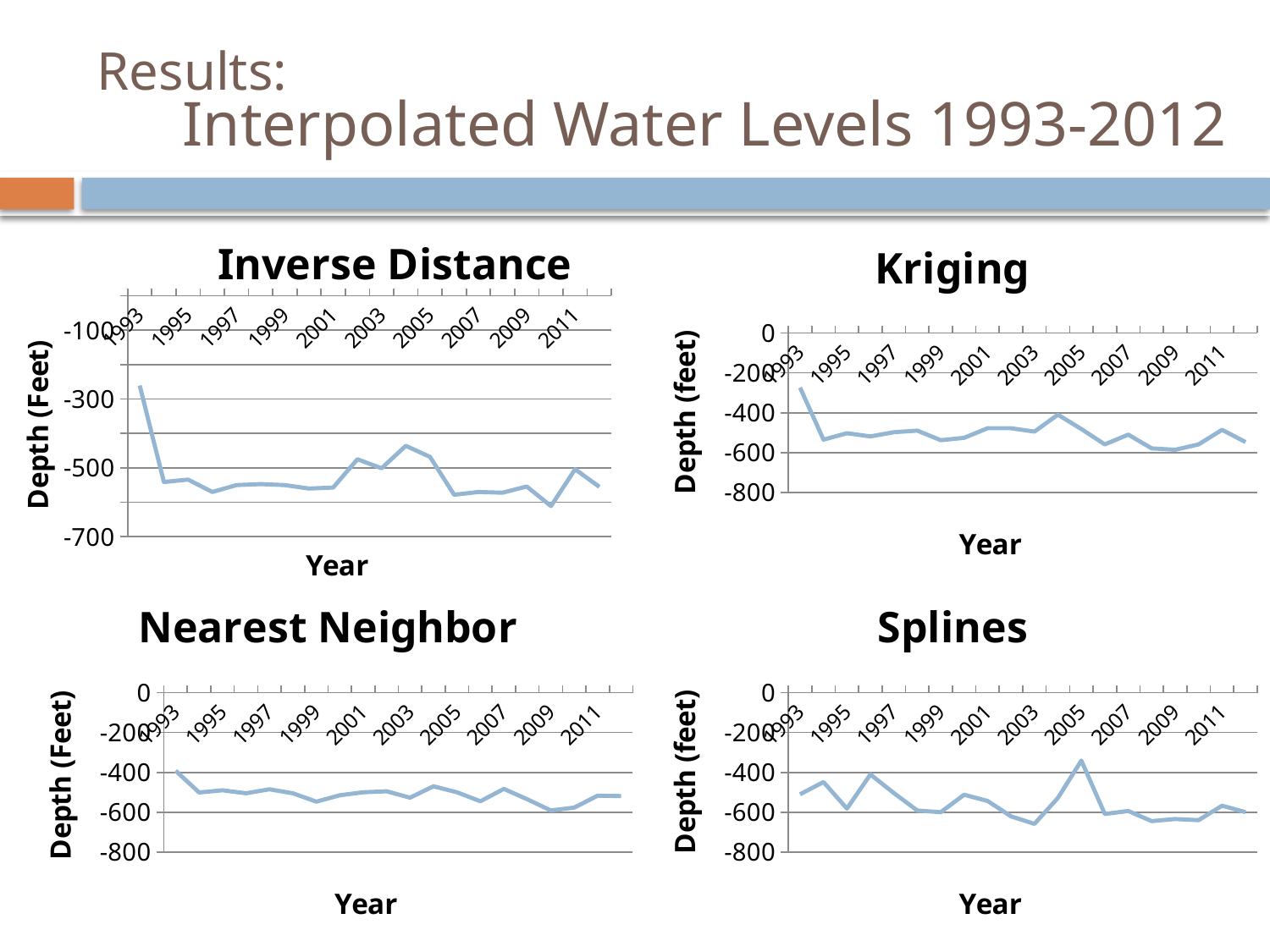
In the Splines chart, which year has the highest depth value? 2005 In the Inverse Distance chart, is the value for 1993 greater or less than -300? greater In the Inverse Distance chart, which year has the highest depth value? 1993 In the Kriging chart, is the value for 1993 greater or less than -400? greater What is the y-axis label of the Kriging chart? Depth (feet) In the Splines chart, is the value for 2004 greater or less than -600? greater How many charts are shown on the slide? 4 In the Nearest Neighbor chart, does the value rise or fall from 1993 to 1994? fall In the Kriging chart, which year has the highest depth value? 1993 What kind of chart is the Inverse Distance chart? line chart In the Inverse Distance chart, which year has the lowest depth value? 2010